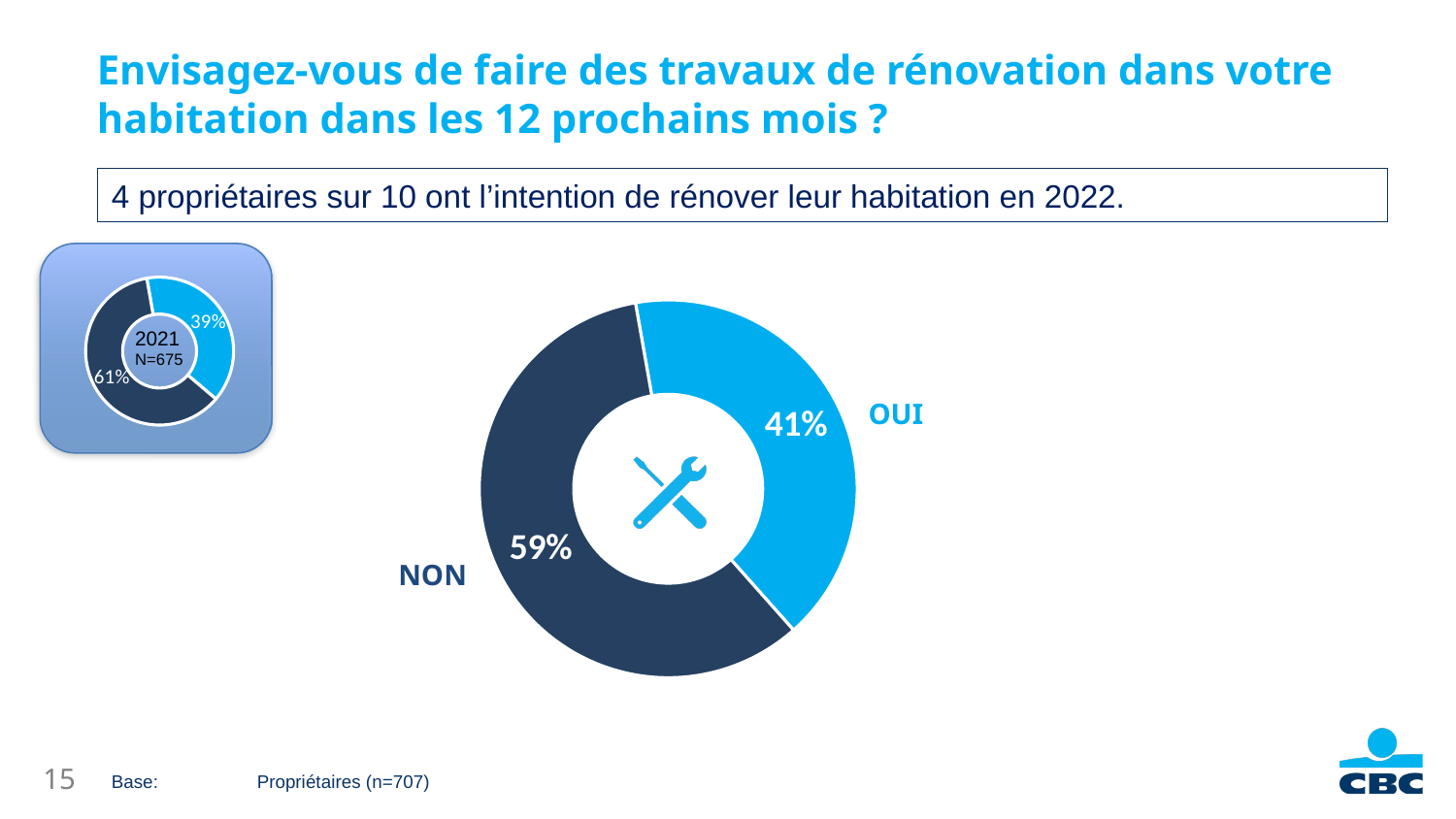
How many categories are shown in the large donut chart in the centre of the slide? 2 In the large donut chart in the centre of the slide, what colour is the OUI segment? Light blue In the large donut chart in the centre of the slide, what percentage is shown for NON? 59% In the large donut chart in the centre of the slide, is the value for NON greater or less than 50%? greater In the large donut chart in the centre of the slide, which category has the smallest share? OUI In the large donut chart in the centre of the slide, what percentage is shown for OUI? 41% What type of chart is the large chart in the centre of the slide? Donut (pie) chart In the small chart on the left of the slide, what year and sample size are written in the centre? 2021, N=675 In the large donut chart in the centre of the slide, what is the difference in percentage points between NON and OUI? 18 In the small chart on the left of the slide, what percentage is shown for the light blue segment? 39% In the large donut chart in the centre of the slide, which category has the larger share, OUI or NON? NON In the small chart on the left of the slide, what percentage is shown for the dark blue segment? 61%